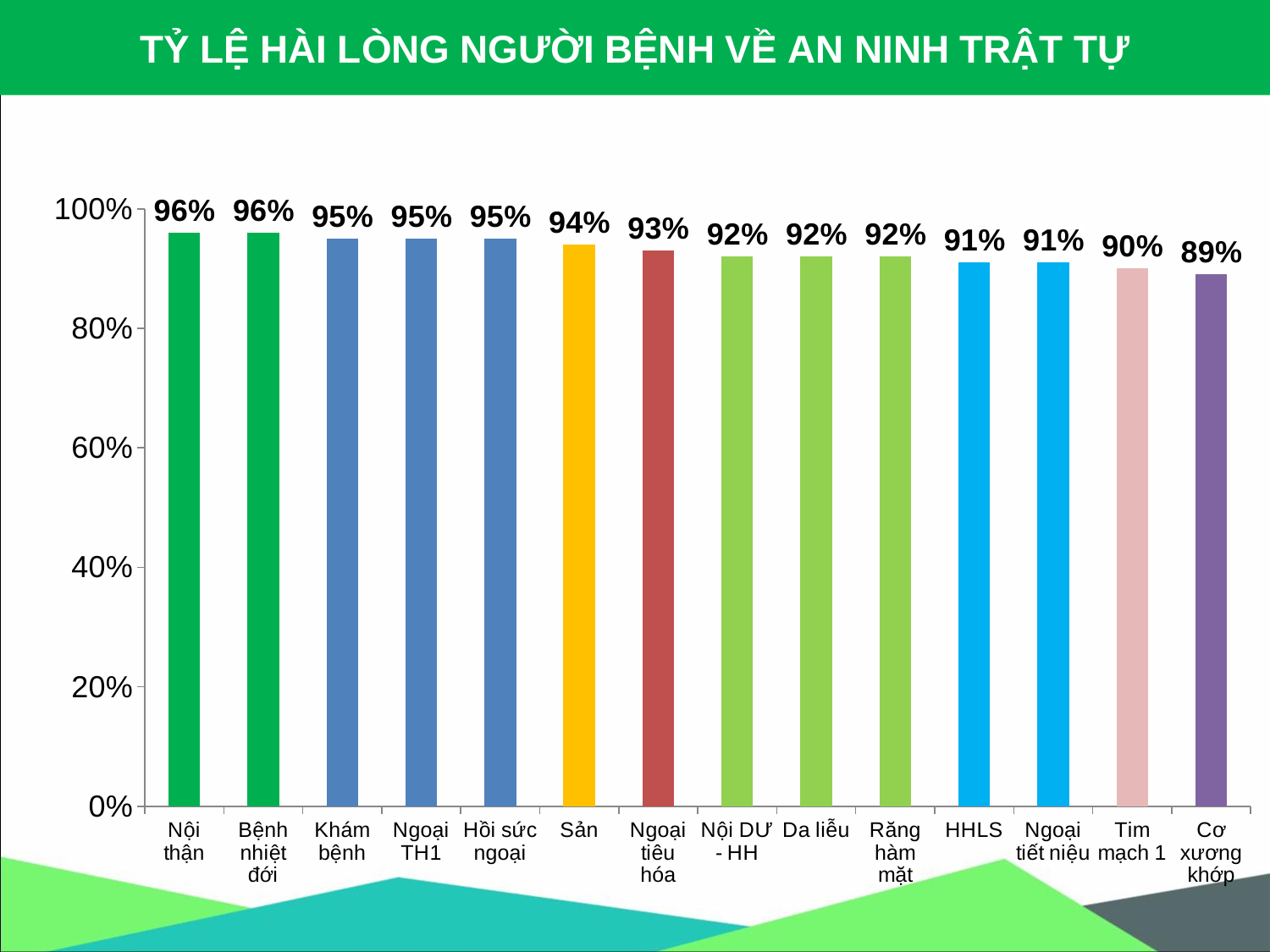
What is the title of the chart? TỶ LỆ HÀI LÒNG NGƯỜI BỆNH VỀ AN NINH TRẬT TỰ Which is larger, the value for Sản or the value for Tim mạch 1? Sản What is the satisfaction rate for Sản? 94% What value is shown for HHLS? 91% What is the difference between the value for Nội thận and the value for Cơ xương khớp? 7% What kind of chart is shown on the slide? Bar chart What is the satisfaction rate for Ngoại tiêu hóa? 93% Do the values rise or fall from left to right across the chart? Fall How many departments are shown on the chart? 14 Which department has the lowest satisfaction rate? Cơ xương khớp What is the value shown for Cơ xương khớp? 89% Is the value for Tim mạch 1 greater or less than 80%? greater